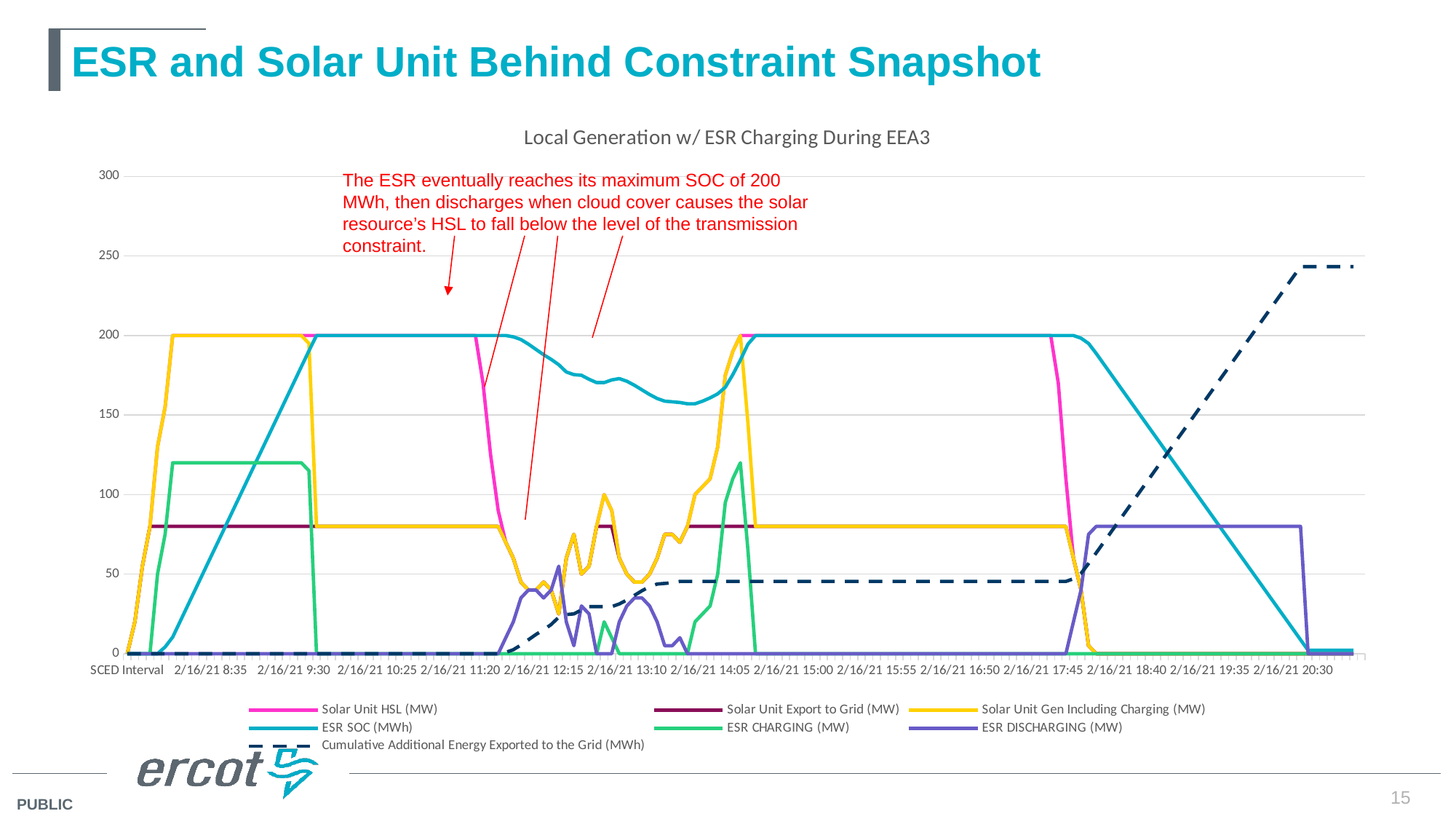
What kind of chart is shown on the slide? line chart Is the peak value of ESR CHARGING (MW) in the morning (before 2/16/21 9:30) greater or less than 100? greater How many series does the chart's legend list? 7 What is the title of the chart? Local Generation w/ ESR Charging During EEA3 Is the value of Solar Unit Export to Grid (MW) during its flat period greater or less than 100? less Which series is drawn with a dashed line? Cumulative Additional Energy Exported to the Grid (MWh) At 2/16/21 15:00, which is larger: ESR SOC (MWh) or Solar Unit Export to Grid (MW)? ESR SOC (MWh) Is the peak value of ESR DISCHARGING (MW) after 2/16/21 17:45 greater or less than 100? less Does the Cumulative Additional Energy Exported to the Grid (MWh) series rise or fall over the course of the day? rise What maximum SOC does the ESR reach, according to the chart annotation? 200 MWh